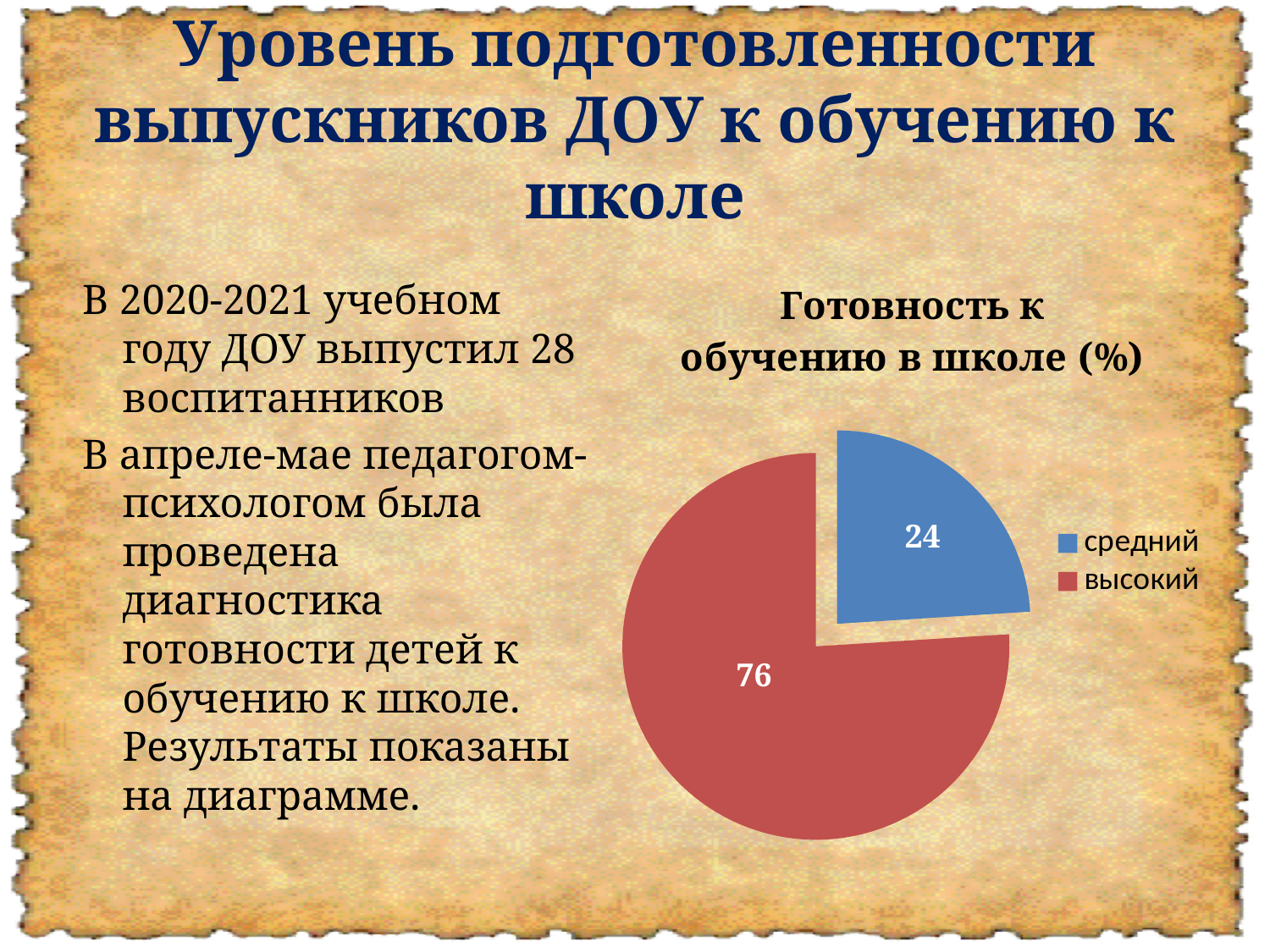
How many entries does the legend list? 2 What share of the pie does the 'средний' slice represent? 24% What is the value for the 'высокий' slice? 76 What type of chart is shown on the slide? pie chart Which category has the largest slice? высокий What is the title of the chart? Готовность к обучению в школе (%) Which is larger, 'средний' or 'высокий'? высокий Which category has the smallest slice? средний What is the difference between the 'высокий' and 'средний' values? 52 What colour is the 'высокий' slice? red What is the value for the 'средний' slice? 24 How many slices does the pie chart have? 2